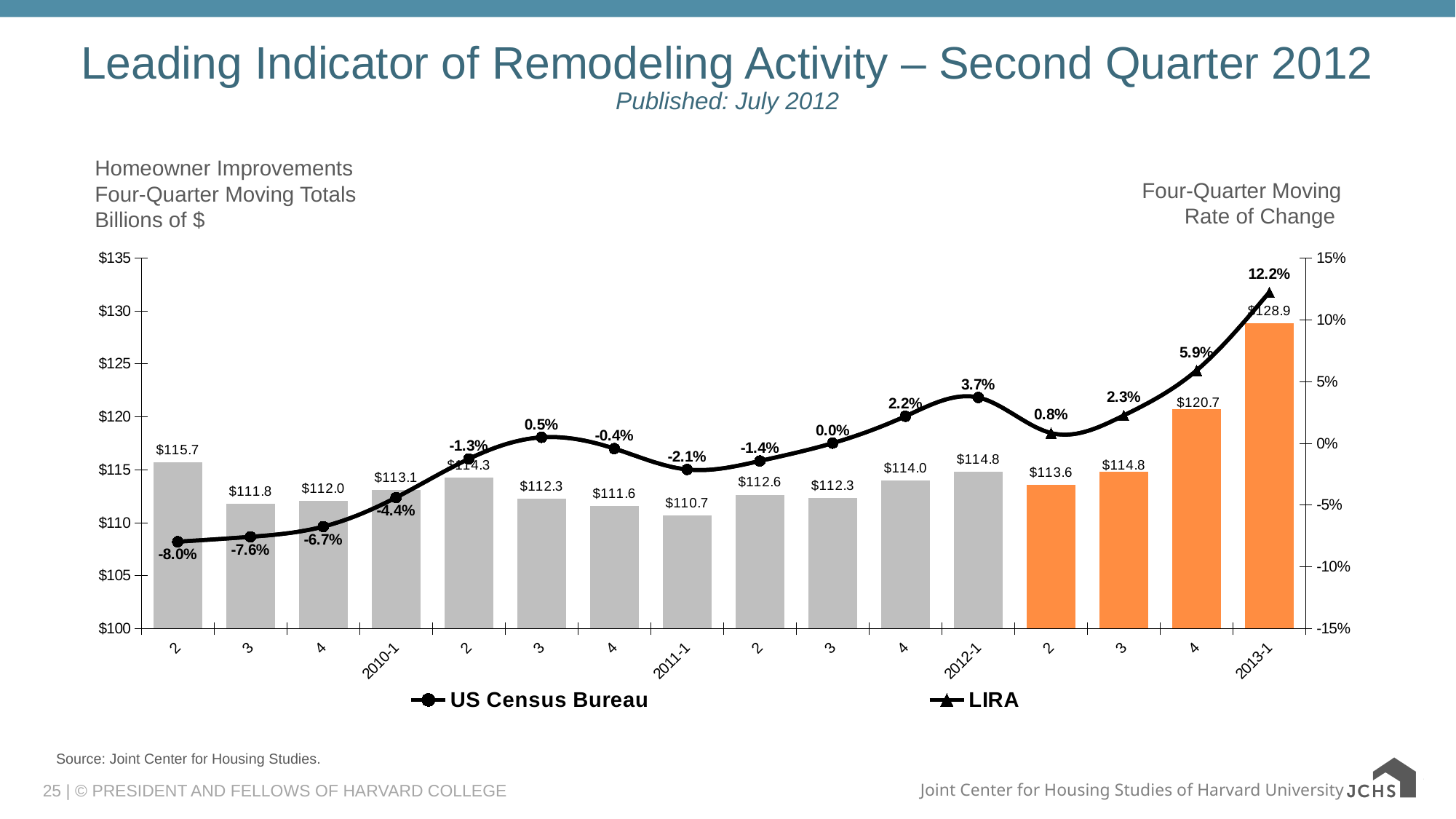
Which quarter has the lowest four-quarter moving total? 2011-1 How many series does the legend list? 2 Which has the larger four-quarter moving total, 2010-1 or 2011-1? 2010-1 What is the four-quarter moving total for 2013-1? $128.9 What is the four-quarter moving rate of change for 2011-1? -2.1% What kind of chart is this? Combination bar and line chart Does the four-quarter moving rate of change rise or fall from 2012-2 to 2013-1? Rise What is the four-quarter moving rate of change for 2012-1? 3.7% Which quarter has the highest four-quarter moving total? 2013-1 What is the difference between the four-quarter moving totals for 2013-1 and 2012-1? $14.1 What is the lowest four-quarter moving rate of change shown on the chart? -8.0% How many quarters (bars) are shown on the chart? 16